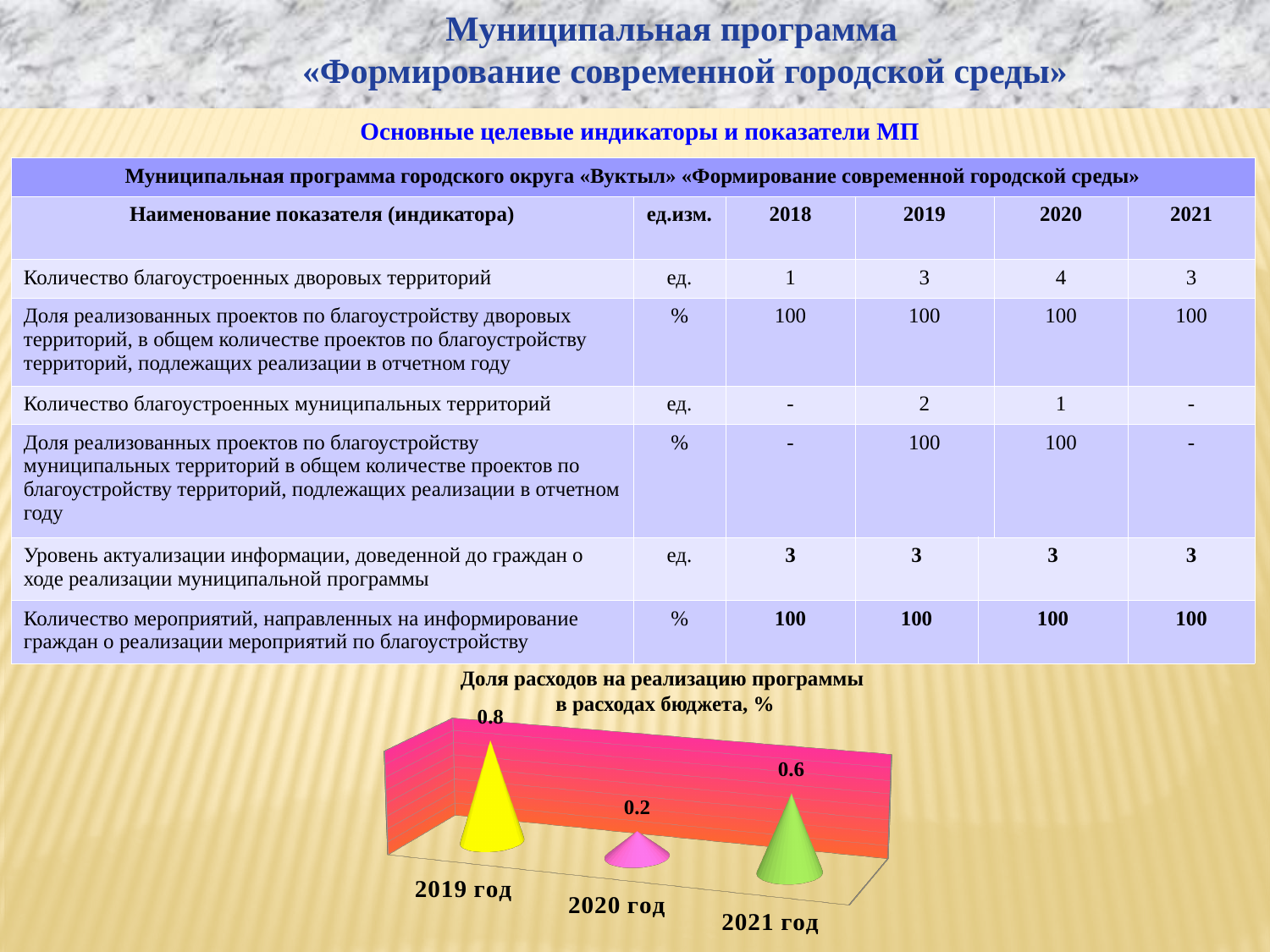
What is the difference between the values for 2019 год and 2020 год in the chart 'Доля расходов на реализацию программы в расходах бюджета, %'? 0.6 Which year has the highest value in the chart 'Доля расходов на реализацию программы в расходах бюджета, %'? 2019 год How many years are shown in the chart 'Доля расходов на реализацию программы в расходах бюджета, %'? 3 What kind of chart is 'Доля расходов на реализацию программы в расходах бюджета, %'? bar chart What is the title of the chart at the bottom of the slide? Доля расходов на реализацию программы в расходах бюджета, % What is the difference between the values for 2021 год and 2020 год in the chart 'Доля расходов на реализацию программы в расходах бюджета, %'? 0.4 In the chart 'Доля расходов на реализацию программы в расходах бюджета, %', does the value rise or fall from 2019 год to 2020 год? fall What is the value for 2021 год in the chart 'Доля расходов на реализацию программы в расходах бюджета, %'? 0.6 What is the value for 2019 год in the chart 'Доля расходов на реализацию программы в расходах бюджета, %'? 0.8 What is the value for 2020 год in the chart 'Доля расходов на реализацию программы в расходах бюджета, %'? 0.2 Which year has the lowest value in the chart 'Доля расходов на реализацию программы в расходах бюджета, %'? 2020 год In the chart 'Доля расходов на реализацию программы в расходах бюджета, %', which is larger: the value for 2019 год or 2021 год? 2019 год